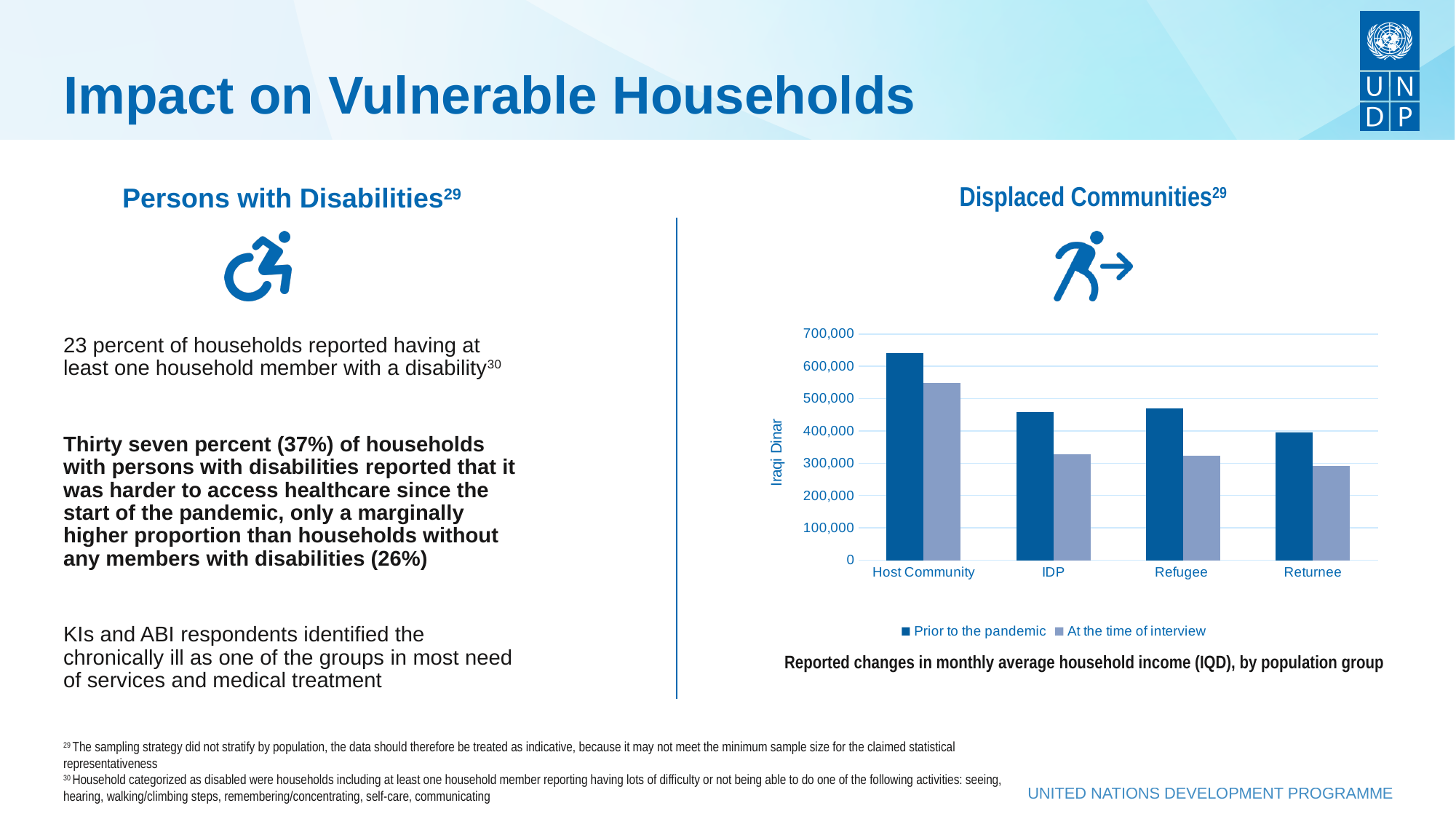
Is the value for IDP prior to the pandemic greater or less than 400,000? greater What are the two series named in the chart's legend? Prior to the pandemic; At the time of interview How many population groups are shown on the x axis of the chart? 4 What is the label on the chart's y axis? Iraqi Dinar Is the value for Host Community at the time of interview greater or less than 500,000? greater For Host Community, which is larger: income prior to the pandemic or at the time of interview? Prior to the pandemic How many series does the chart's legend list? 2 Which population group has the lowest income at the time of interview? Returnee What kind of chart is shown on the slide? bar chart Which population group has the highest income prior to the pandemic? Host Community Is the value for Host Community prior to the pandemic greater or less than 600,000? greater